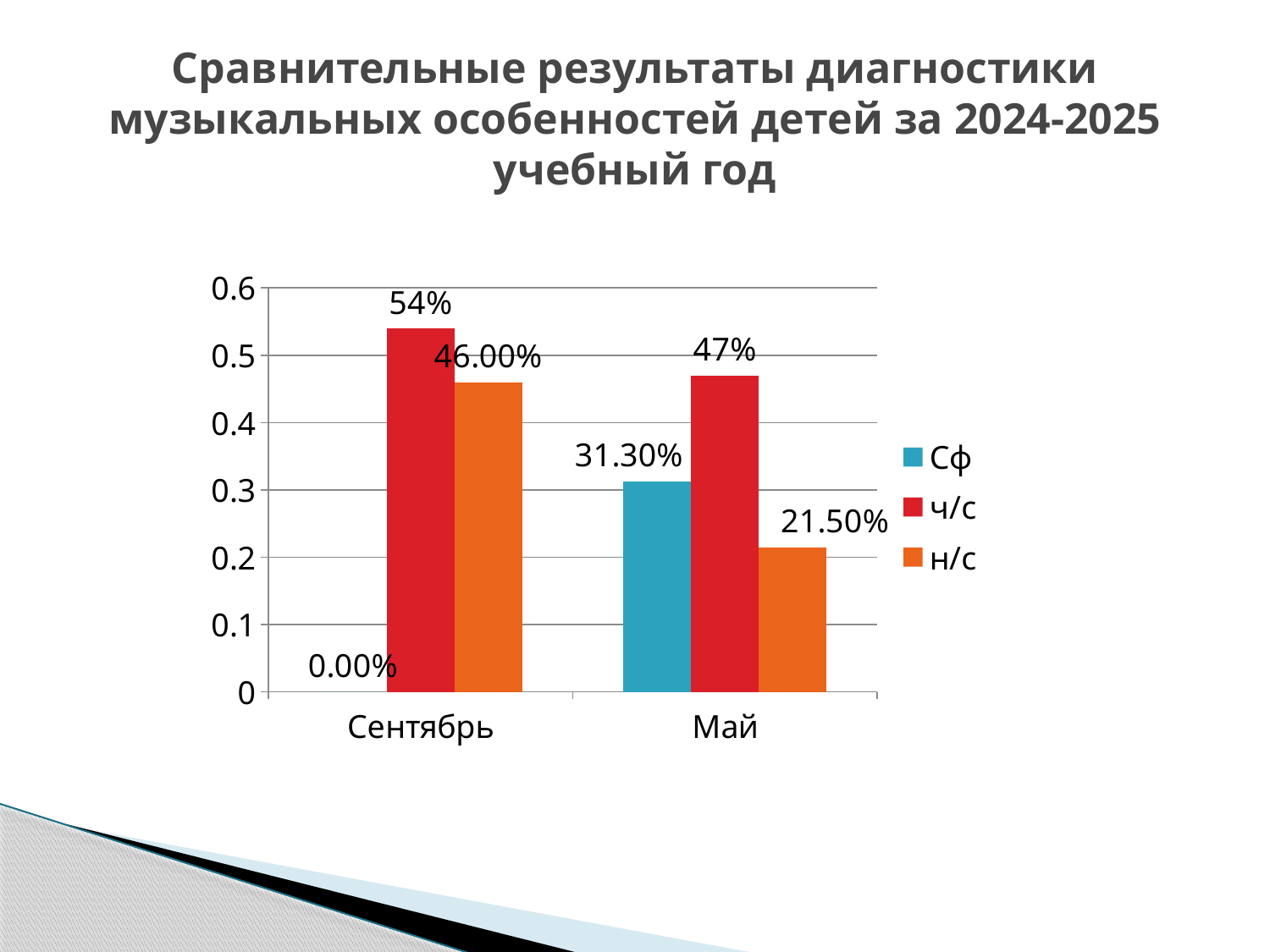
What is the value for ч/с in Сентябрь? 54% What is the value for Сф in Май? 31.30% What kind of chart is shown on the slide? Bar chart What is the value for н/с in Май? 21.50% Which colour represents the ч/с series in the legend? Red How many series does the legend list? 3 How many categories are shown on the x axis? 2 What is the value for Сф in Сентябрь? 0.00% What is the difference between the ч/с values for Сентябрь and Май? 7% Which series has the highest value in Май? ч/с Which series has the lowest value in Сентябрь? Сф Which is larger: н/с in Сентябрь or н/с in Май? н/с in Сентябрь